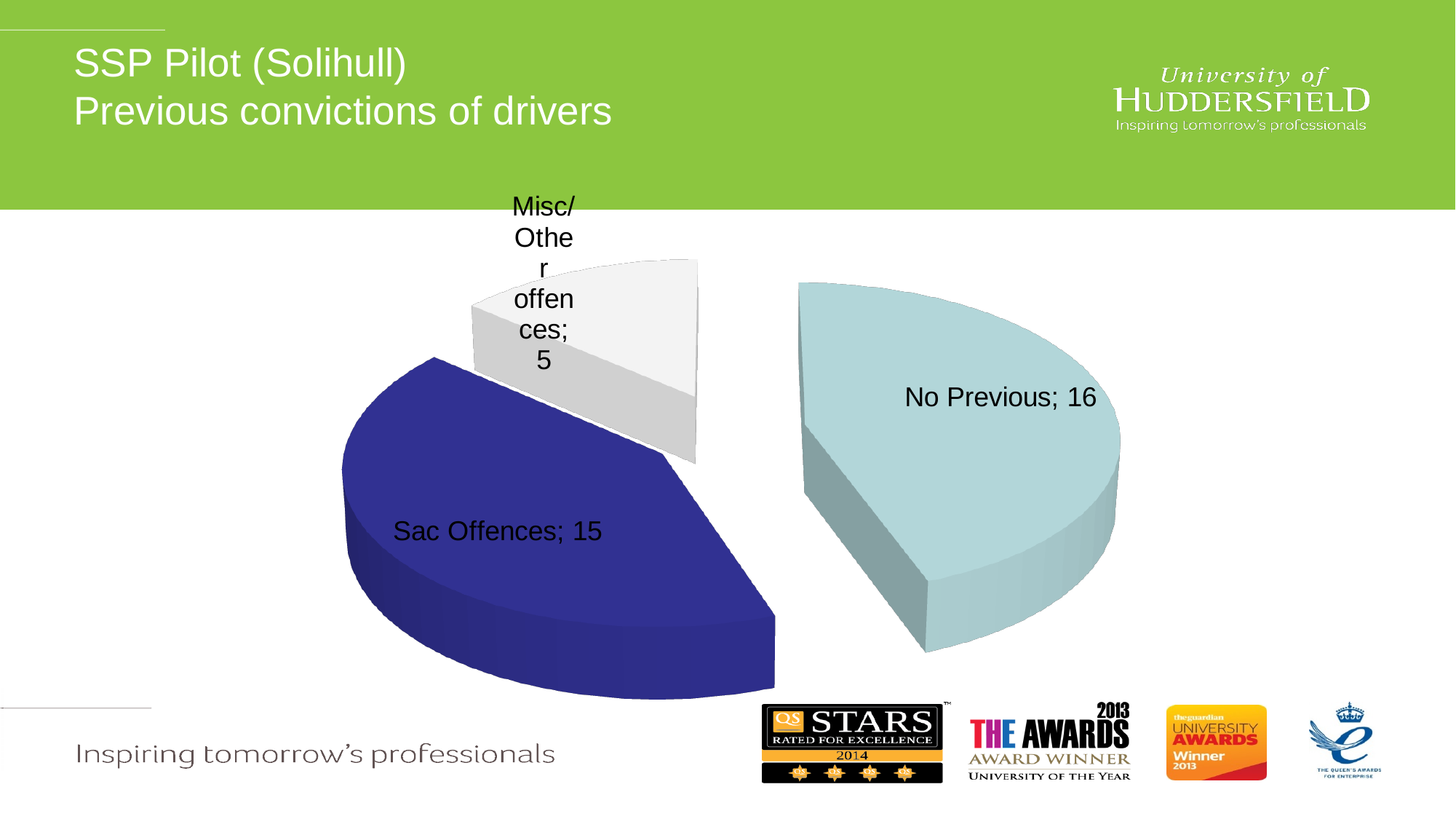
Which is larger, the value for Sac Offences or the value for Misc/Other offences? Sac Offences What is the title of the slide containing the pie chart? SSP Pilot (Solihull) Previous convictions of drivers What is the total of all the slices in the pie chart? 36 How many slices does the pie chart have? 3 What is the value for Misc/Other offences? 5 Which category has the smallest value? Misc/Other offences Which category has the largest value? No Previous What kind of chart is shown on the slide? pie chart What is the value for No Previous? 16 What is the difference between the values for No Previous and Sac Offences? 1 What is the difference between the values for Sac Offences and Misc/Other offences? 10 What is the value for Sac Offences? 15